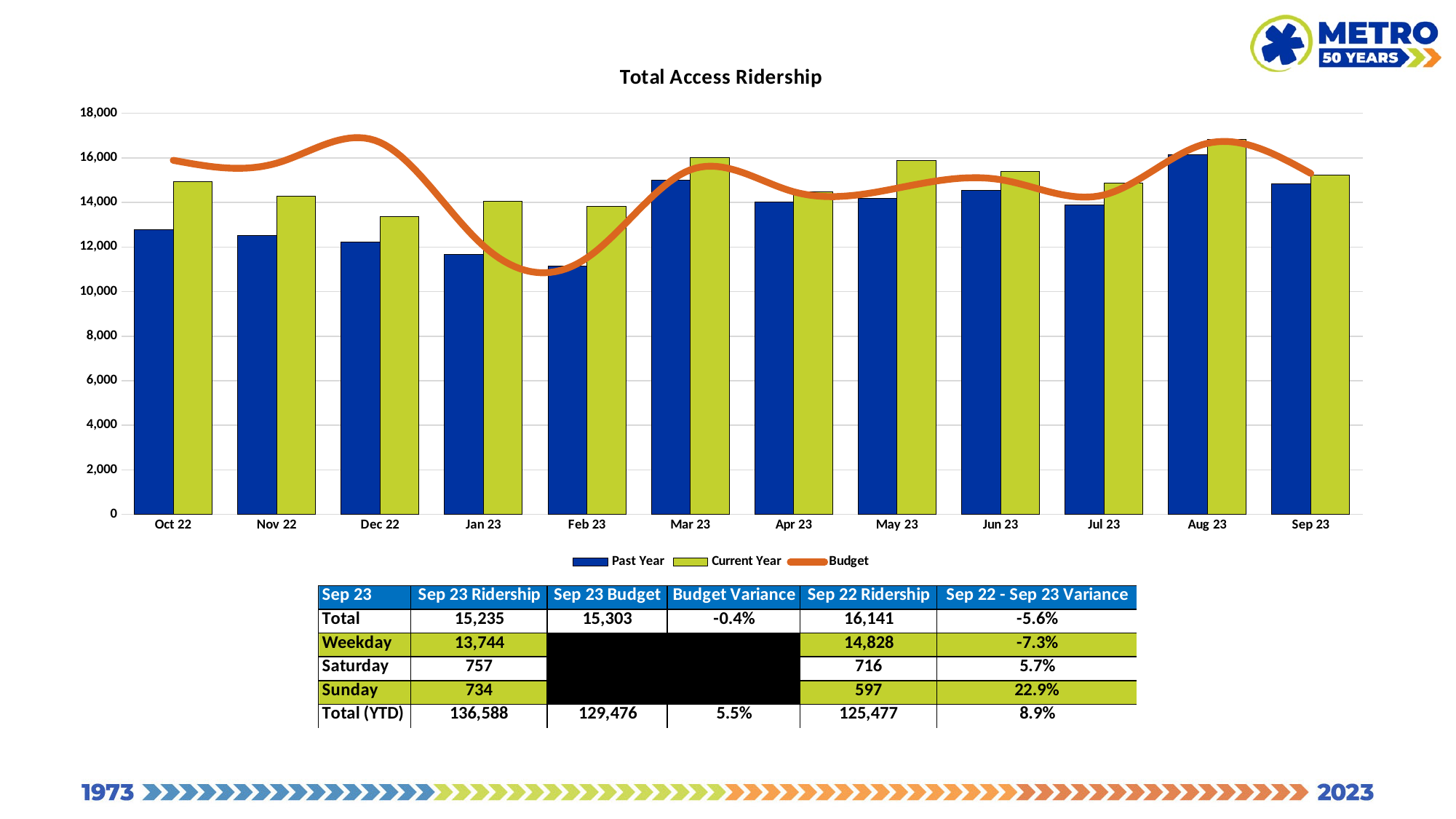
Is the Past Year value for Oct 22 greater or less than 12,000? greater Does the Past Year series rise or fall from Oct 22 to Feb 23? fall Is the Past Year value for Jan 23 greater or less than 12,000? less Which month has the highest Past Year bar? Aug 23 What is the title of the chart? Total Access Ridership How many months are shown on the x axis? 12 How many series does the legend list? 3 What kind of chart is shown on the slide? bar chart with a line In Oct 22, which is larger, the Past Year bar or the Current Year bar? Current Year Which month has the lowest Past Year bar? Feb 23 Which month has the highest Current Year bar? Aug 23 Which month has the lowest Current Year bar? Dec 22